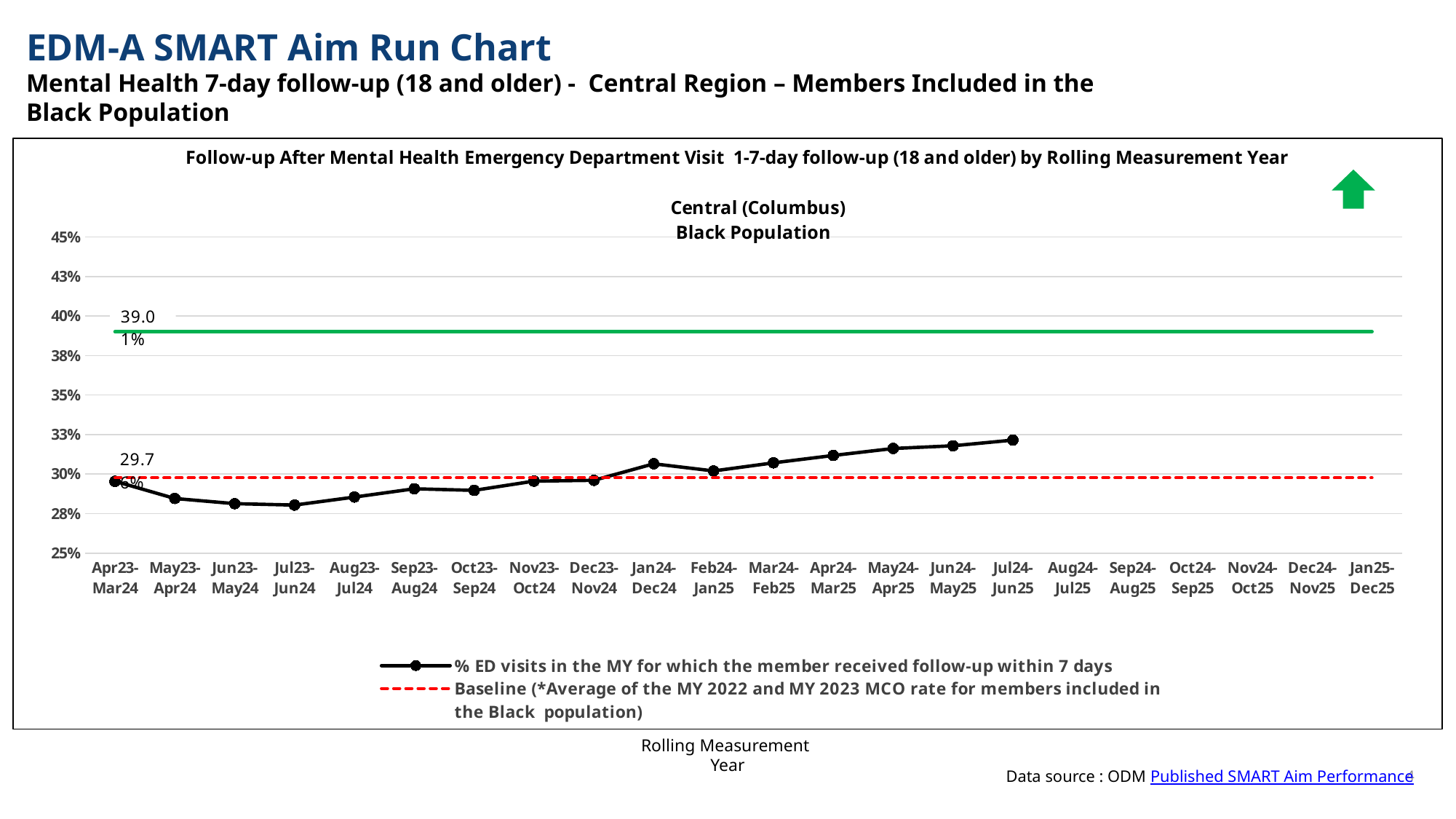
How many data points are plotted on the black line? 16 Is the plotted value for Jul23-Jun24 greater or less than 30%? less How many rolling measurement year categories are labelled on the x axis? 22 What value is labelled on the green goal line? 39.01% Which is larger, the plotted value for Apr23-Mar24 or for Jul24-Jun25? Jul24-Jun25 What kind of chart is shown on the slide? line chart Do the plotted values rise or fall from Jul23-Jun24 to Jul24-Jun25? rise Is the plotted value for Jul24-Jun25 greater or less than 30%? greater How many series does the chart legend list? 2 Which rolling measurement year has the highest plotted value on the black line? Jul24-Jun25 What region and population are named in the chart subtitle? Central (Columbus) Black Population Is the plotted value for Jul24-Jun25 greater or less than 35%? less